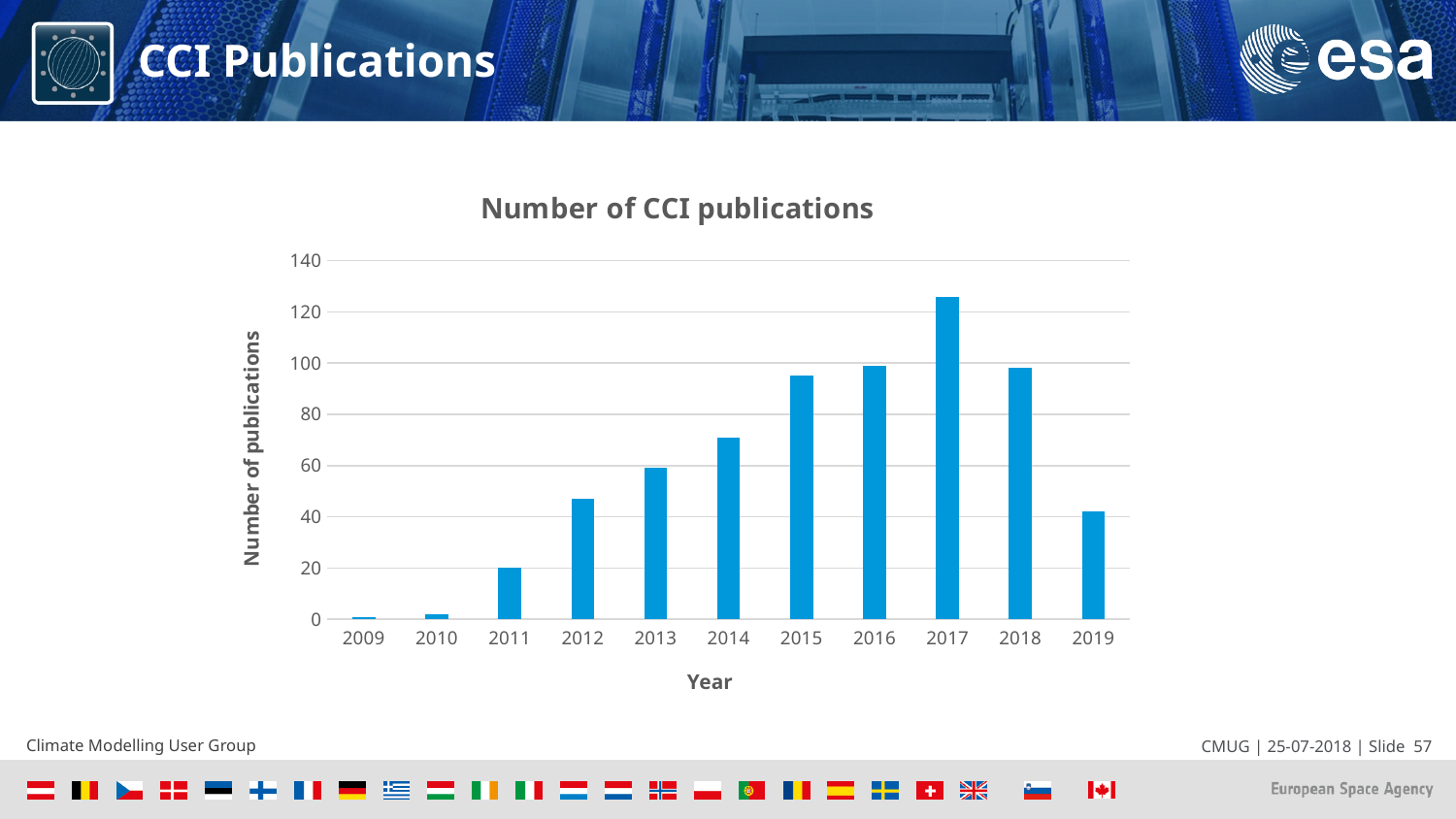
Which year has the highest number of CCI publications? 2017 What is the title of the chart? Number of CCI publications Which year has more publications, 2014 or 2015? 2015 Is the number of publications in 2015 greater or less than 100? less Is the number of publications in 2017 greater or less than 120? greater Do the number of publications rise or fall from 2009 to 2017? rise Is the number of publications in 2014 greater or less than 60? greater How many years are shown on the x axis of the chart? 11 What is the number of CCI publications in 2011? 20 What type of chart is shown on the slide? Bar chart What is the label of the vertical axis? Number of publications